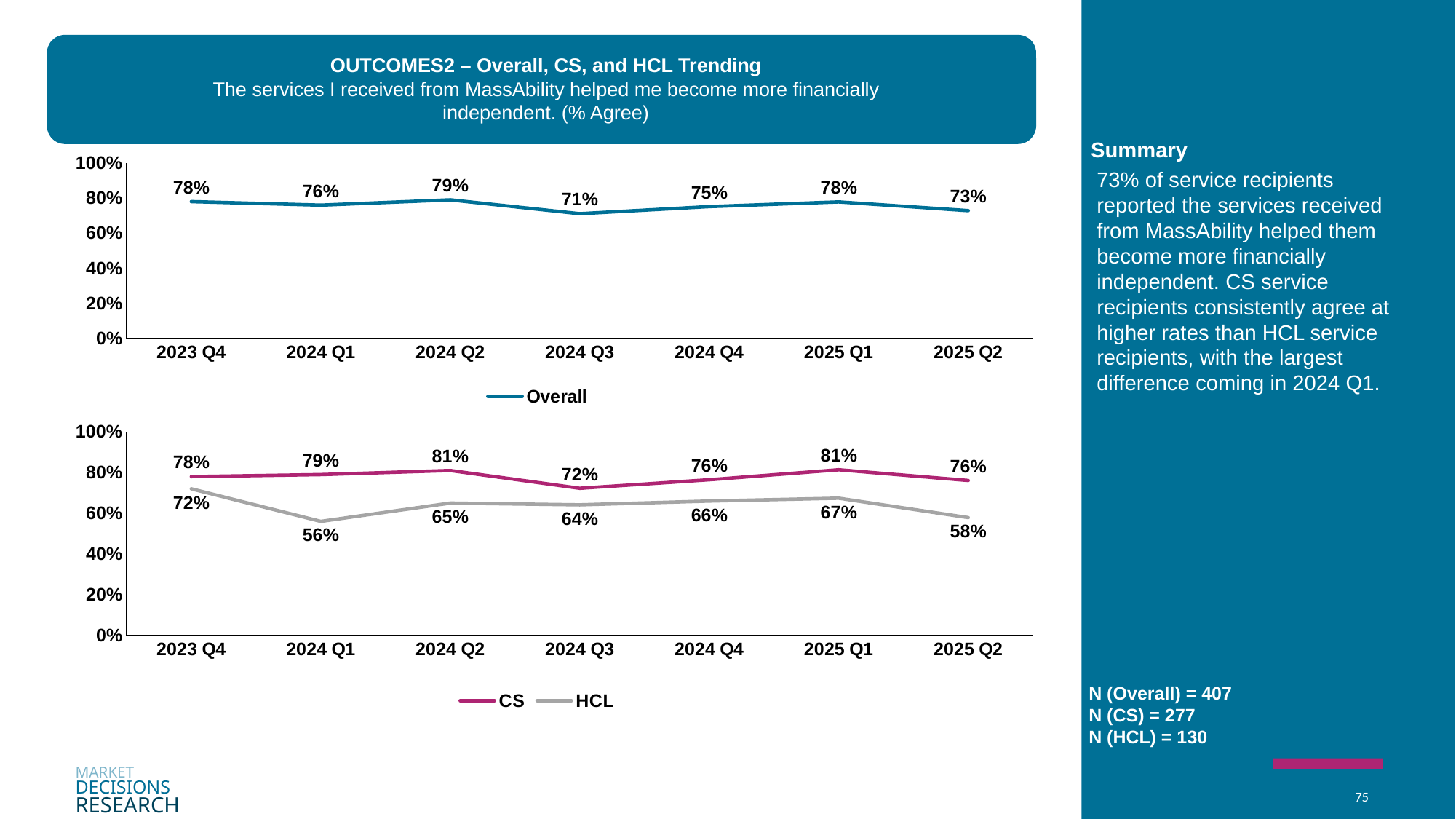
In the bottom chart (CS and HCL), what is the CS value for 2025 Q1? 81% How many series does the legend of the bottom chart list? 2 In the bottom chart (CS and HCL), what is the HCL value for 2024 Q1? 56% In the bottom chart (CS and HCL), which quarter has the lowest HCL value? 2024 Q1 In the top chart (Overall), which quarter has the lowest value? 2024 Q3 In the top chart (Overall), what is the value for 2024 Q3? 71% What kind of chart is the top chart? Line chart In the top chart (Overall), what is the difference between the 2023 Q4 value and the 2025 Q2 value? 5% In the top chart (Overall), which quarter has the highest value? 2024 Q2 In the bottom chart (CS and HCL), which is larger in 2025 Q2, the CS value or the HCL value? CS How many quarters are plotted on the x axis of the top chart? 7 In the bottom chart (CS and HCL), what is the difference between the CS and HCL values in 2024 Q1? 23%